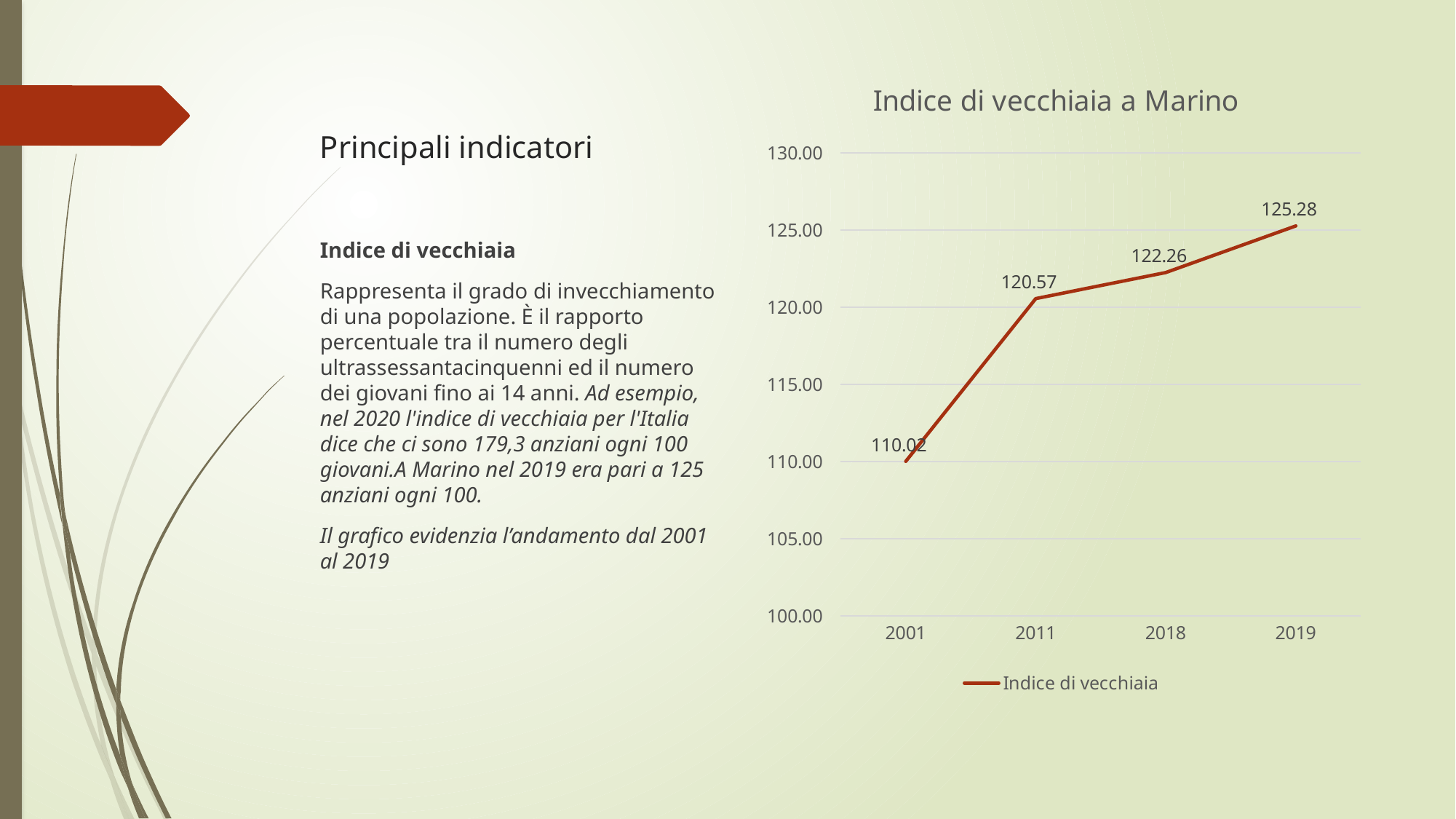
What is the value of Indice di vecchiaia for 2011? 120.57 Which year has the highest Indice di vecchiaia? 2019 Which year has the lowest Indice di vecchiaia? 2001 What is the difference between the Indice di vecchiaia in 2019 and in 2001? 15.26 What is the value of Indice di vecchiaia for 2018? 122.26 What is the value of Indice di vecchiaia for 2019? 125.28 Does the Indice di vecchiaia rise or fall from 2001 to 2019? rise What is the value of Indice di vecchiaia for 2001? 110.02 How many years are plotted on the chart? 4 What kind of chart is shown on the slide? line chart How many series does the legend list? 1 Which is larger, the Indice di vecchiaia in 2011 or in 2018? 2018